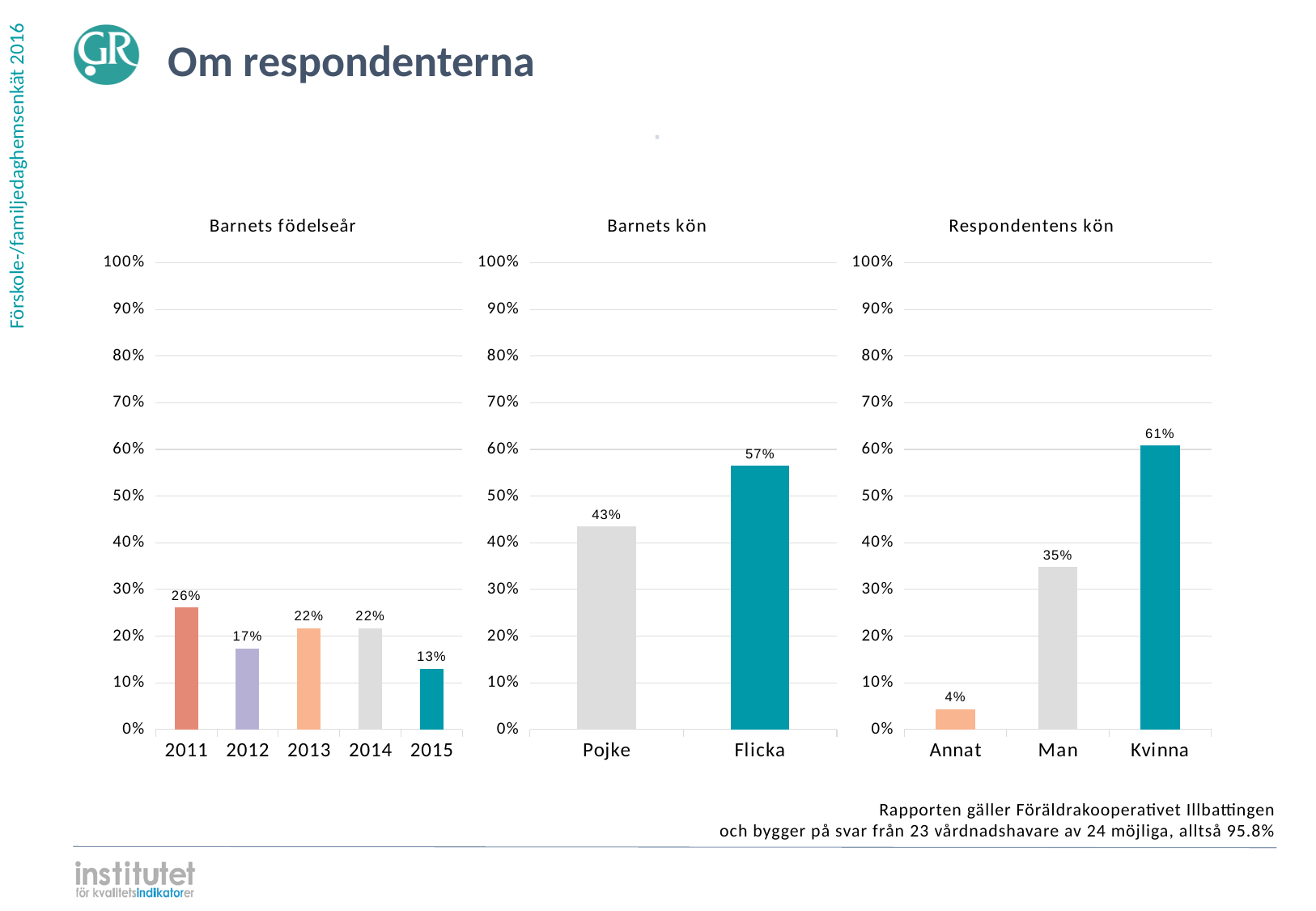
In the 'Barnets födelseår' chart, what is the difference between the values for 2011 and 2015? 13% What kind of chart is the 'Respondentens kön' chart? Bar chart In the 'Barnets födelseår' chart, which year has the highest value? 2011 In the 'Barnets kön' chart, which category is larger, Pojke or Flicka? Flicka In the 'Respondentens kön' chart, what is the value for Man? 35% In the 'Barnets födelseår' chart, which year has the lowest value? 2015 In the 'Barnets kön' chart, what is the difference between Flicka and Pojke? 14% In the 'Barnets födelseår' chart, what is the value for 2011? 26% In the 'Respondentens kön' chart, what is the difference between Kvinna and Man? 26% In the 'Barnets födelseår' chart, how many years are shown on the x axis? 5 In the 'Respondentens kön' chart, which category has the lowest value? Annat In the 'Barnets kön' chart, what is the value for Pojke? 43%